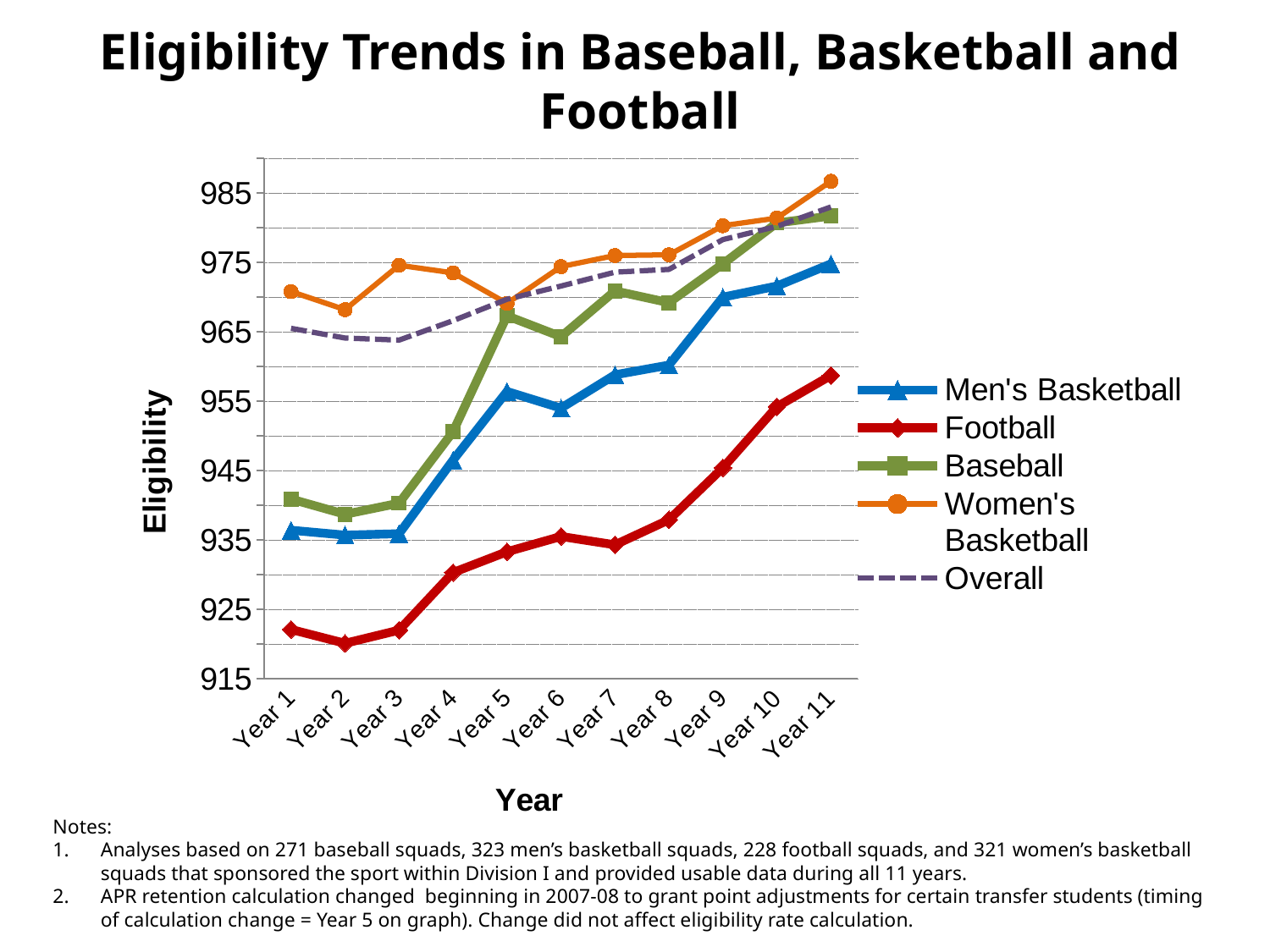
How many series does the legend list? 5 Which series is drawn with a dashed line? Overall In Year 2, which is larger: Women's Basketball or Overall? Women's Basketball Is the value for Men's Basketball in Year 11 greater or less than 965? greater Is the value for Football in Year 1 greater or less than 925? less Is the value for Baseball in Year 1 greater or less than 945? less Which series has the lowest value in Year 1? Football Which series has the highest value in Year 11? Women's Basketball Does the Football line rise or fall from Year 1 to Year 11? rise How many years are plotted along the x axis? 11 What kind of chart is shown on the slide? line chart In Year 6, which is larger: Baseball or Men's Basketball? Baseball